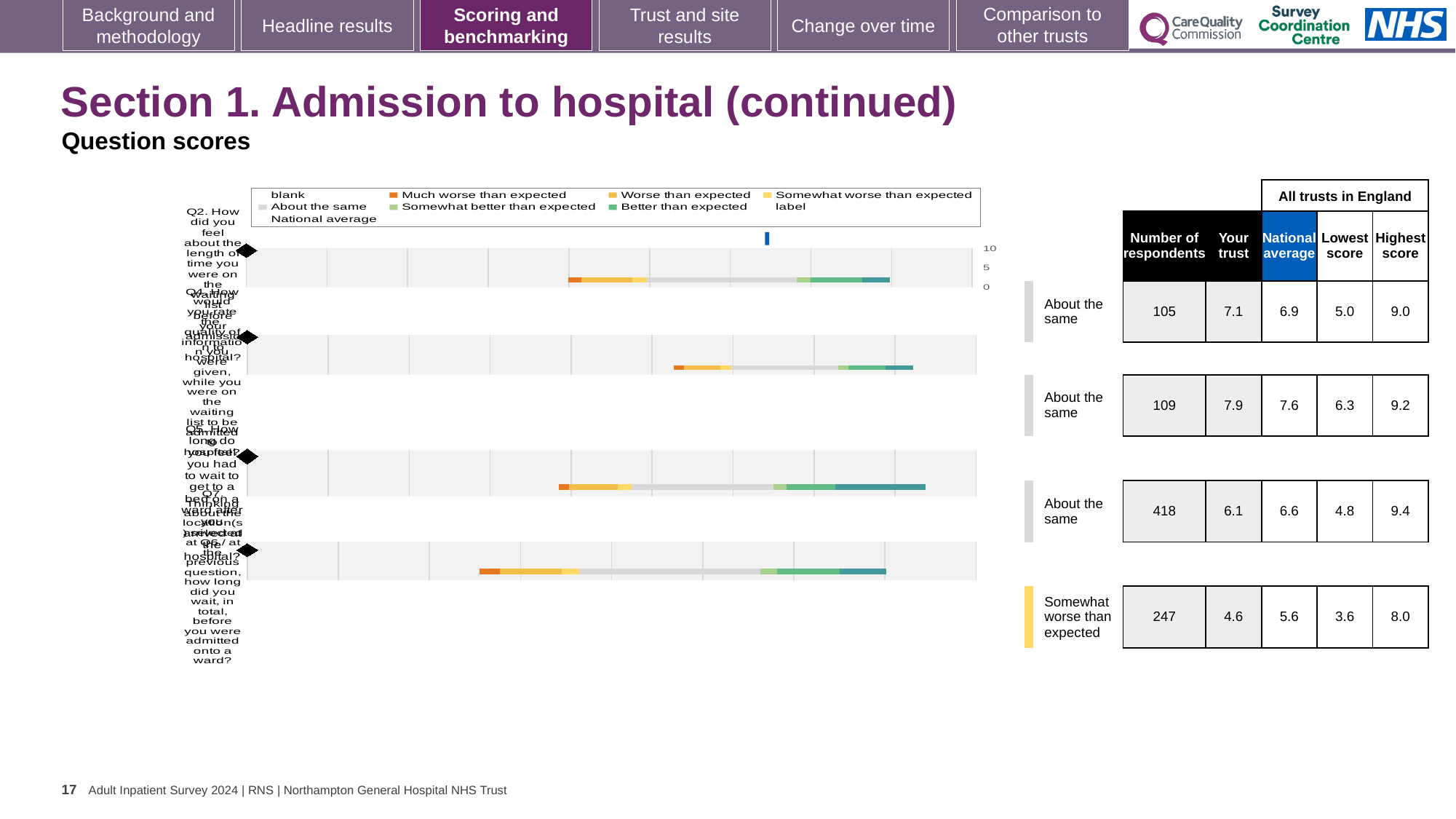
In the table to the right of the chart, what is the 'Highest score' for the second row? 9.2 What is the highest tick value shown on the chart's score axis? 10 In the table to the right of the chart, what is the number of respondents for the third row? 418 What benchmark label is shown beside the fourth (bottom) bar of the chart? Somewhat worse than expected In the table to the right of the chart, what is the 'Your trust' score for the first row? 7.1 In the table to the right of the chart, which row has the highest 'Your trust' score? the second row (7.9) In the table to the right of the chart, what is the 'Lowest score' for the fourth row? 3.6 How many question bars are plotted in the chart? 4 In the table to the right of the chart, what is the difference between the 'National average' and the 'Your trust' score in the fourth row? 1.0 What kind of chart is shown on the slide? bar chart In the table to the right of the chart, for the third row, which is larger: the 'Your trust' score or the 'National average'? National average How many entries does the chart's legend list? 9